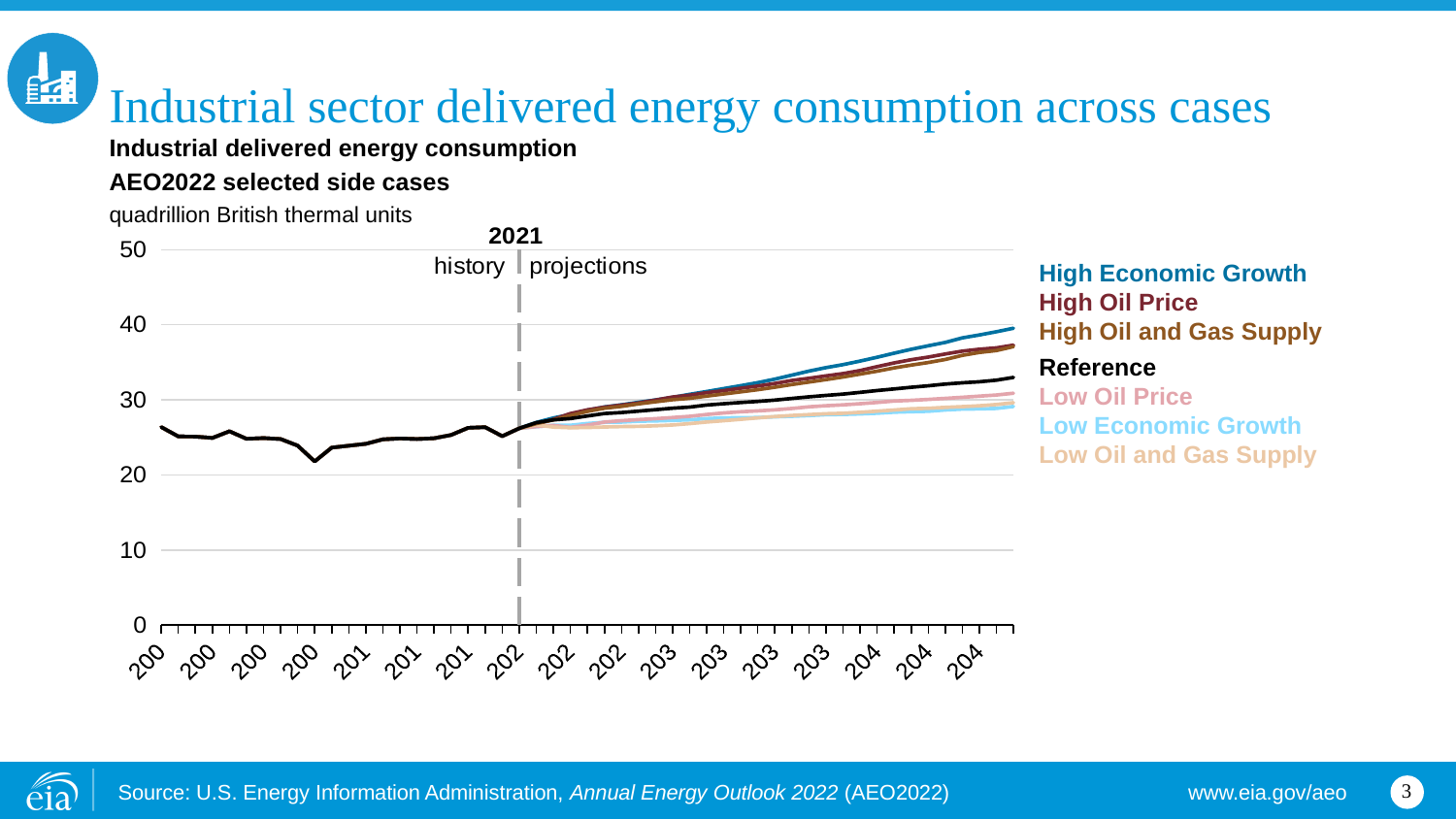
What unit is the y axis measured in? quadrillion British thermal units What year does the dashed vertical line separating history from projections mark? 2021 Is the value for Reference at the end of the projection period greater or less than 30? greater Is the value for High Economic Growth at the end of the projection period greater or less than 30? greater What kind of chart is shown on the slide? line chart How many series does the legend list? 7 At the end of the projection period, which is larger: Reference or Low Oil Price? Reference Is the value for Low Economic Growth at the end of the projection period greater or less than 30? less Which series has the highest value at the end of the projection period? High Economic Growth Does the High Economic Growth line rise or fall over the projection period? rise